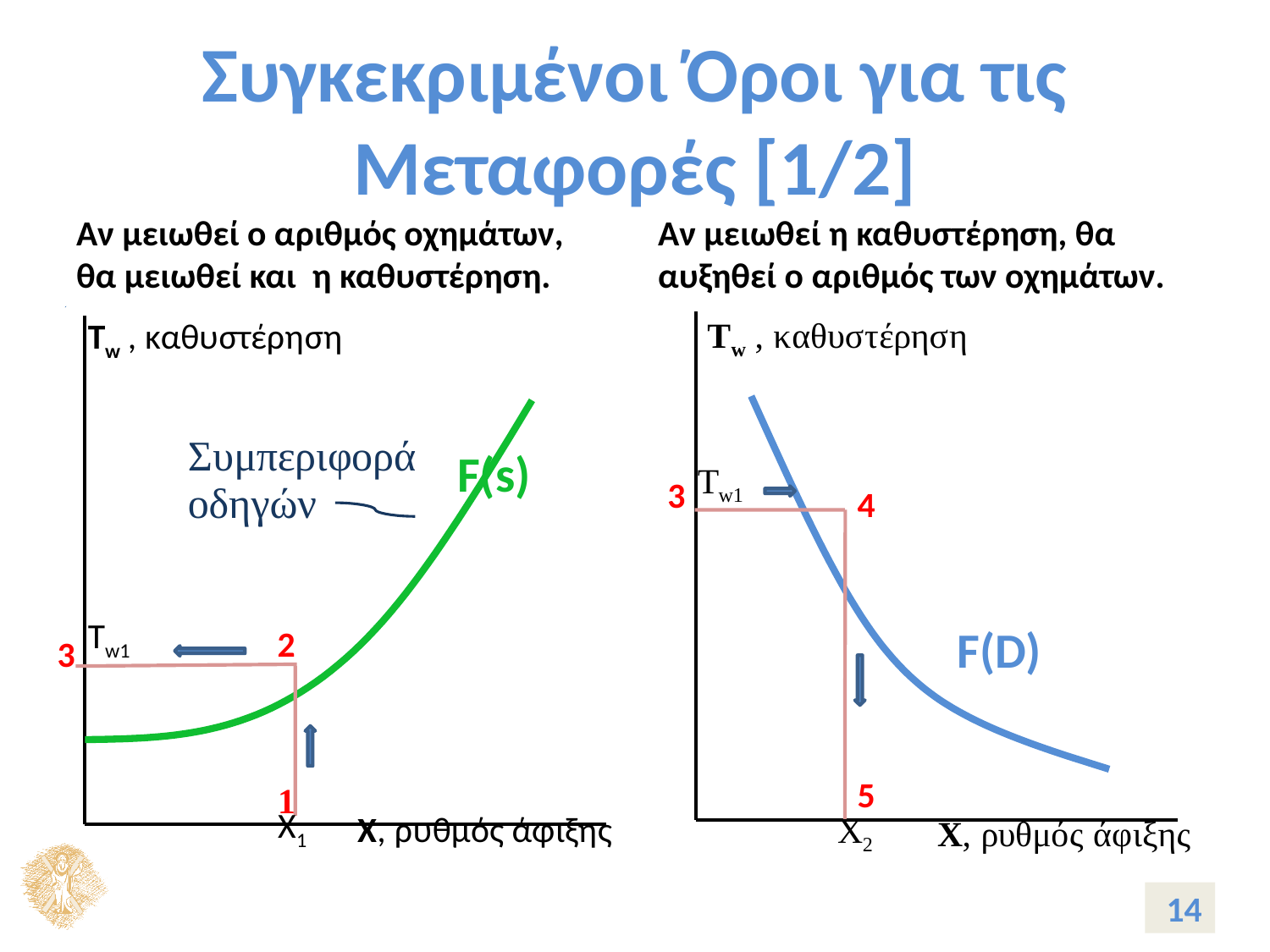
What kind of chart is the left chart labelled F(s)? line chart On the left chart, does the F(s) curve rise or fall as X (ρυθμός άφιξης) increases? rises On the right chart, does the F(D) curve rise or fall as X (ρυθμός άφιξης) increases? falls On the left chart, is the delay Tw at the right end of the F(s) curve higher or lower than the delay Tw1 at X1? higher What is the label of the horizontal axis on the right chart? X, ρυθμός άφιξης How many charts are shown on the slide? 2 What kind of chart is the right chart labelled F(D)? line chart On the right chart, is the delay Tw at the right end of the F(D) curve higher or lower than the delay Tw1 at X2? lower What is the label of the curve on the left chart? F(s)